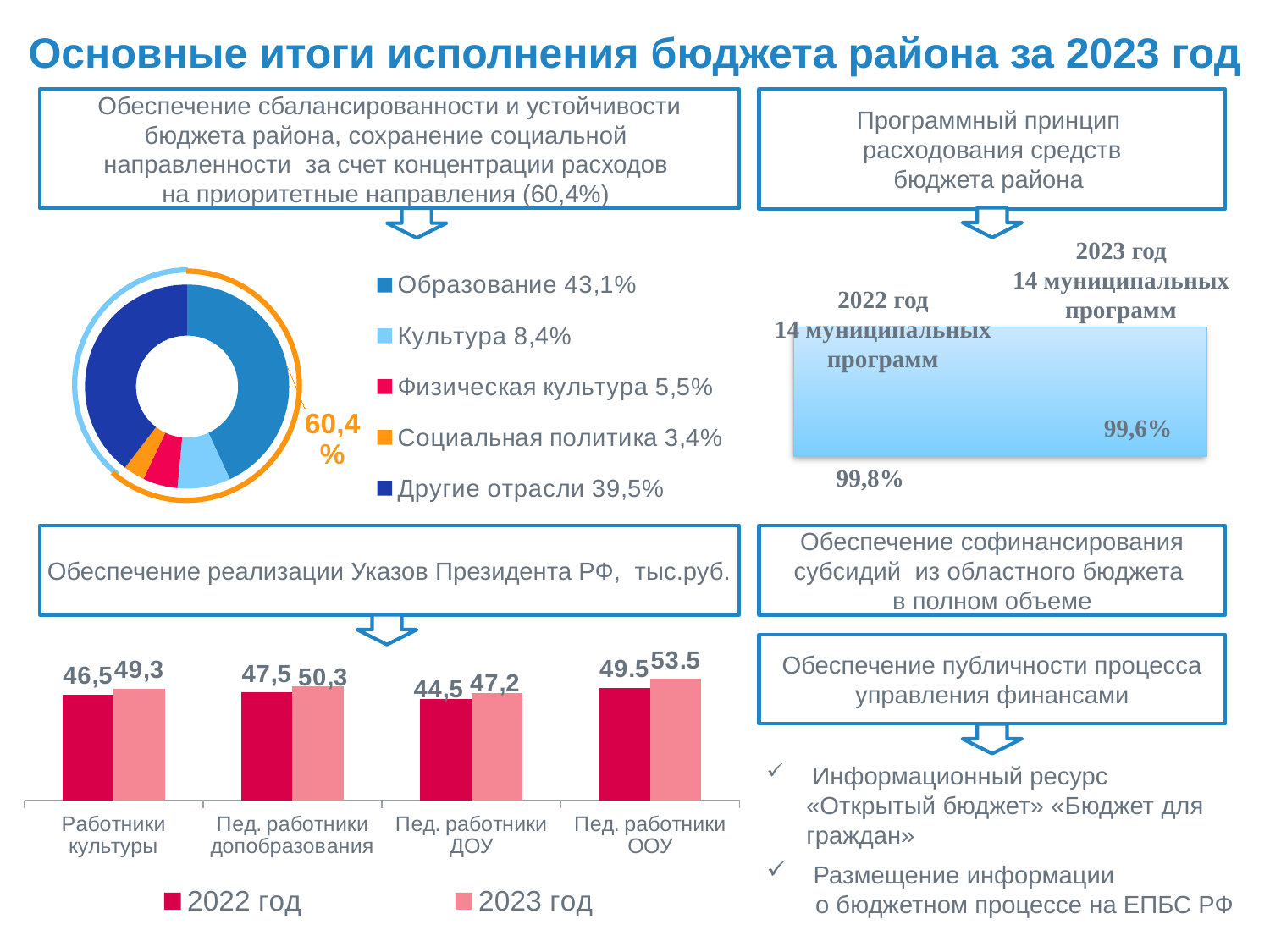
In the bar chart 'Обеспечение реализации Указов Президента РФ, тыс.руб.', which category has the highest value for 2023 год? Пед. работники ООУ How many series does the legend of the bar chart 'Обеспечение реализации Указов Президента РФ, тыс.руб.' list? 2 What type of chart is the chart on the left showing Образование, Культура and other sectors? Doughnut chart In the doughnut chart on the left, what share does Образование have? 43,1% In the doughnut chart on the left, what share does Социальная политика have? 3,4% In the bar chart 'Обеспечение реализации Указов Президента РФ, тыс.руб.', what is the value for Пед. работники ДОУ in 2023 год? 47,2 In the doughnut chart on the left, which category has the largest share? Образование How many categories does the legend of the doughnut chart on the left list? 5 In the bar chart 'Обеспечение реализации Указов Президента РФ, тыс.руб.', which is larger for Пед. работники ООУ: 2022 год or 2023 год? 2023 год In the bar chart 'Обеспечение реализации Указов Президента РФ, тыс.руб.', what is the value for Работники культуры in 2022 год? 46,5 In the doughnut chart on the left, which category has the smallest share? Социальная политика In the bar chart 'Обеспечение реализации Указов Президента РФ, тыс.руб.', what is the difference between the 2023 год and 2022 год values for Пед. работники допобразования? 2,8